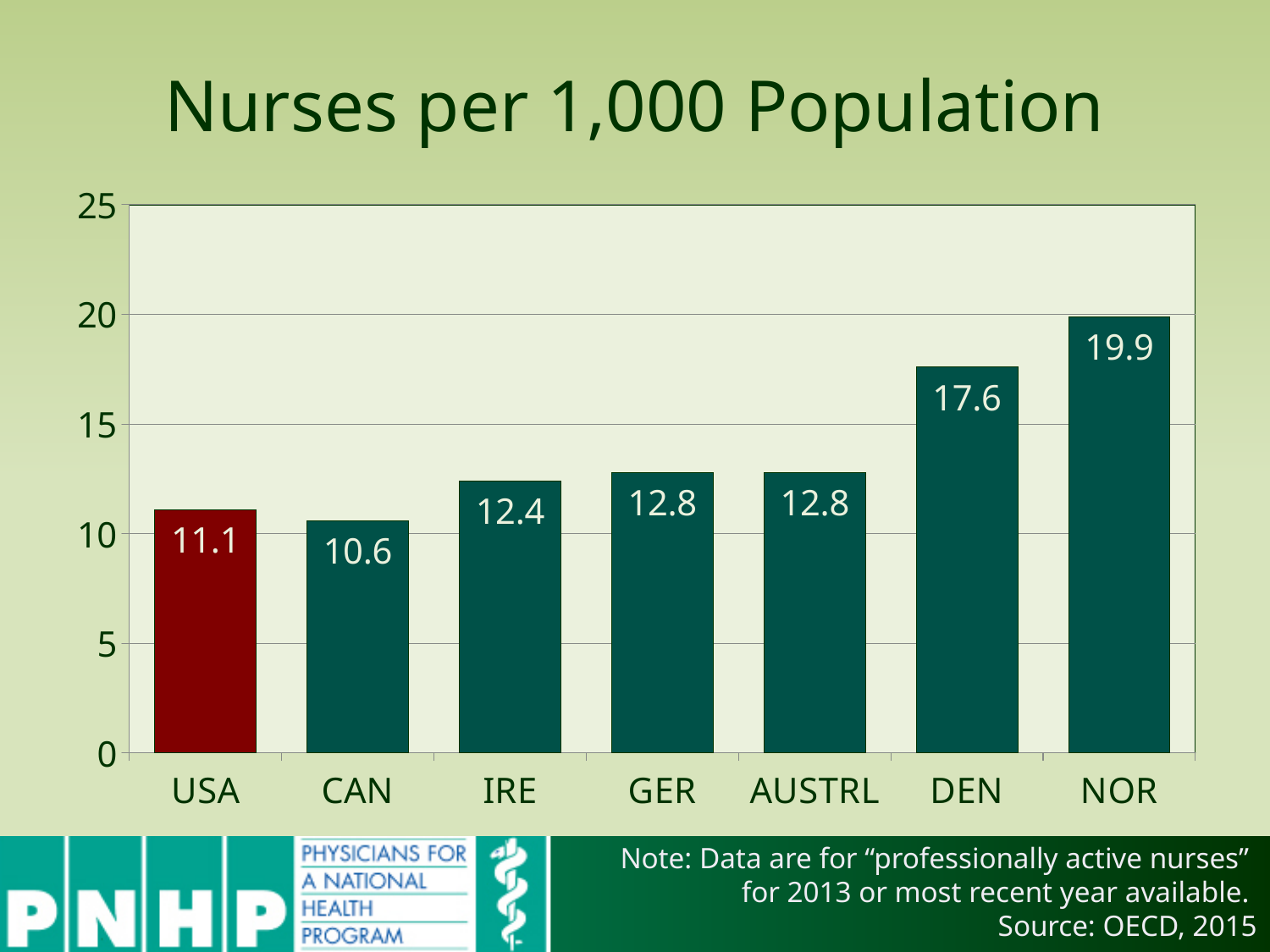
What kind of chart is shown on the slide? bar chart Which country has the highest number of nurses per 1,000 population? NOR What is the value for DEN? 17.6 Which is larger, the value for IRE or the value for USA? IRE Is the value for DEN greater or less than 15? greater What is the value for NOR? 19.9 What is the difference between the values for NOR and USA? 8.8 What is the difference between the values for DEN and CAN? 7 What is the title of the chart? Nurses per 1,000 Population Which country has the lowest number of nurses per 1,000 population? CAN How many countries are shown in the chart? 7 What is the value for USA? 11.1